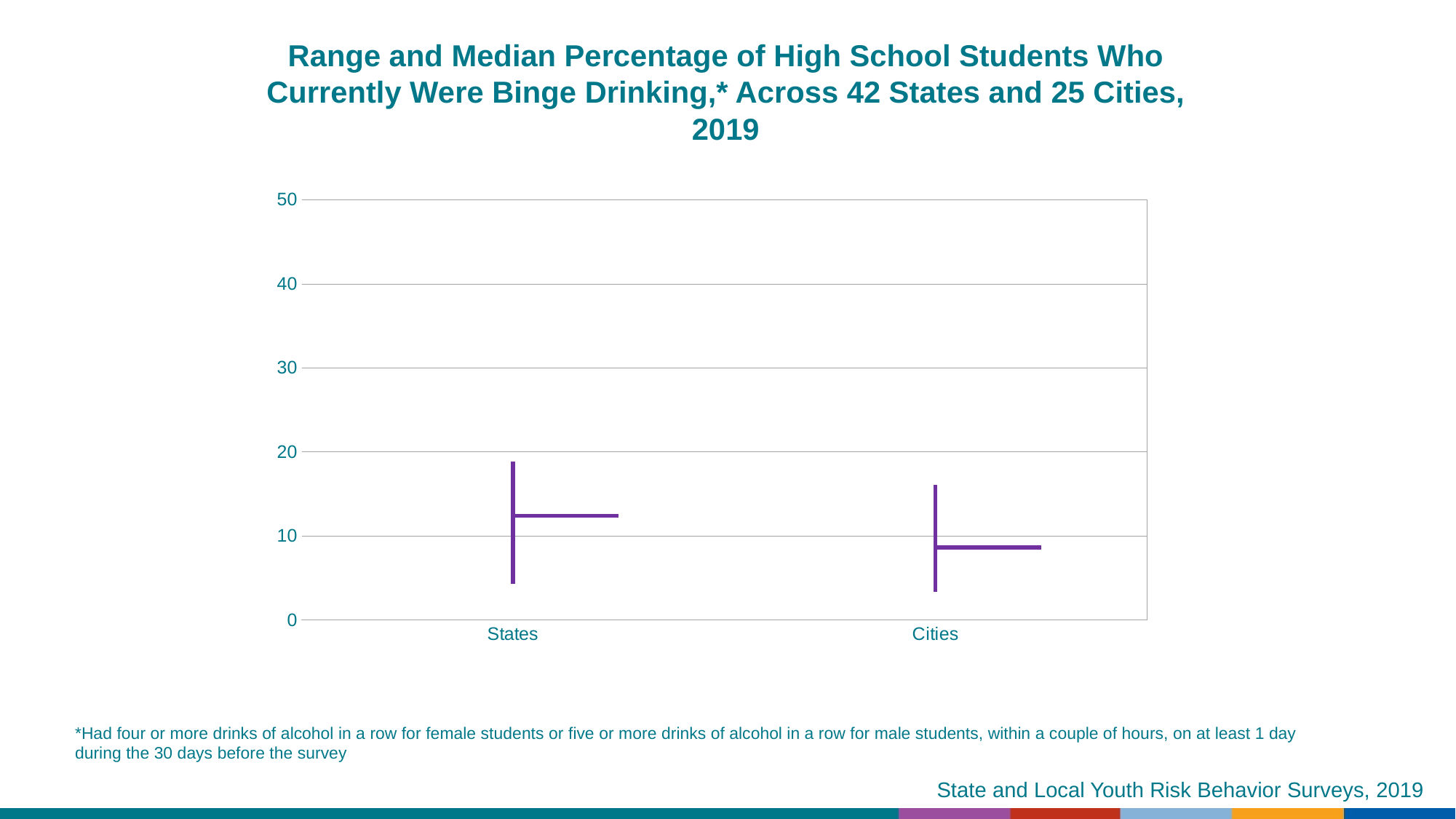
Is the top of the range for Cities greater or less than 10? greater Is the median value for States greater or less than 10? greater According to the chart title, how many states and how many cities are included? 42 states and 25 cities Is the top of the range for Cities greater or less than 20? less What is the highest value shown on the y axis of the chart? 50 Which category has the lower median percentage? Cities Which category has the higher top of its range, States or Cities? States Which category has the higher median percentage, States or Cities? States How many categories are shown on the x axis of the chart? 2